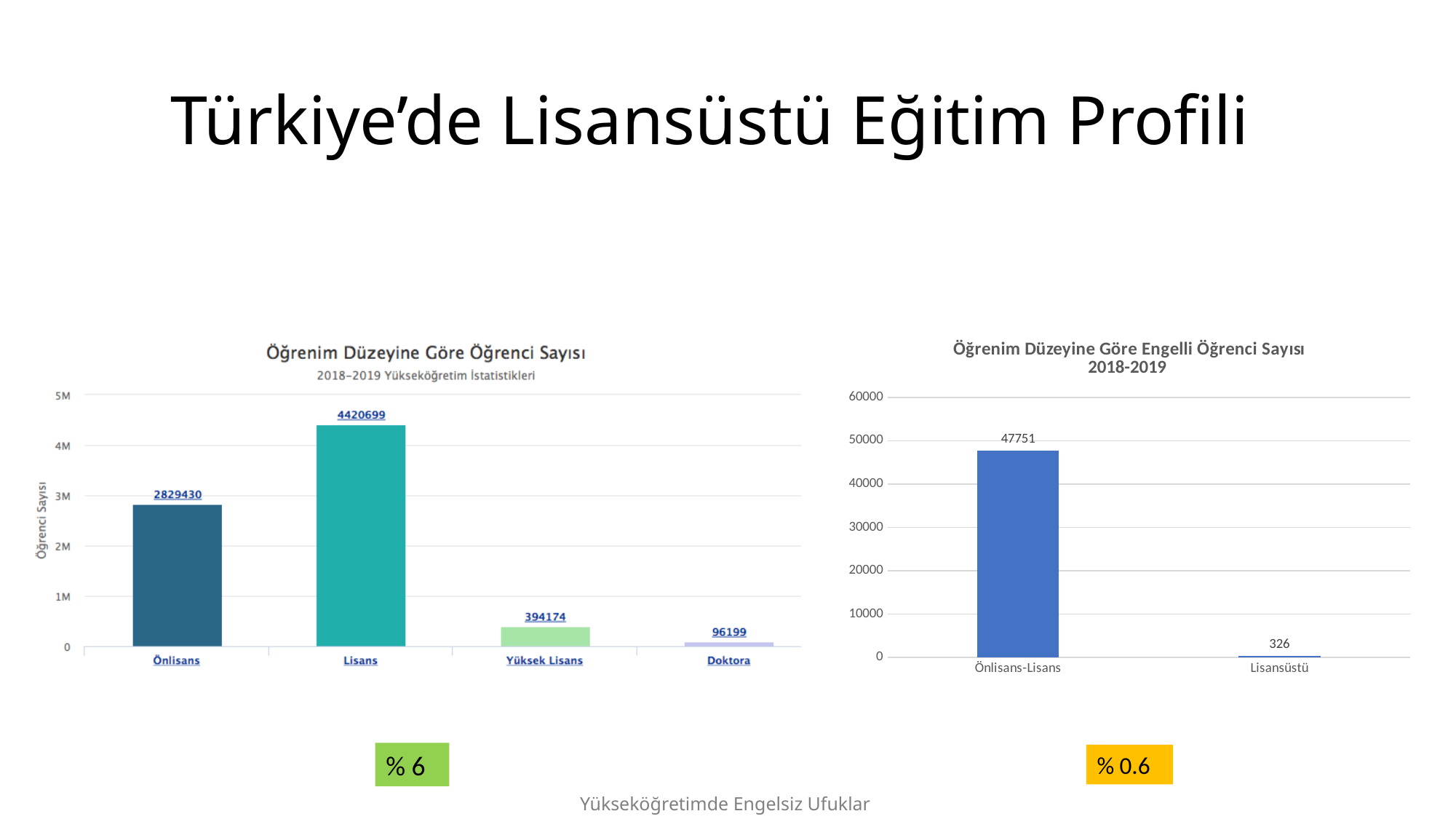
In the chart titled 'Öğrenim Düzeyine Göre Öğrenci Sayısı', which category has the lowest value? Doktora In the chart titled 'Öğrenim Düzeyine Göre Öğrenci Sayısı', which category has the highest value? Lisans In the chart titled 'Öğrenim Düzeyine Göre Engelli Öğrenci Sayısı 2018-2019', what is the value for Önlisans-Lisans? 47751 In the chart titled 'Öğrenim Düzeyine Göre Öğrenci Sayısı', how many categories are shown on the x axis? 4 In the chart titled 'Öğrenim Düzeyine Göre Öğrenci Sayısı', what is the value for Lisans? 4420699 What is the subtitle shown under the title of the chart on the left side of the slide? 2018-2019 Yükseköğretim İstatistikleri What kind of chart is the one on the right side of the slide? bar chart In the chart titled 'Öğrenim Düzeyine Göre Engelli Öğrenci Sayısı 2018-2019', what is the value for Lisansüstü? 326 In the chart titled 'Öğrenim Düzeyine Göre Öğrenci Sayısı', what is the value for Doktora? 96199 In the chart titled 'Öğrenim Düzeyine Göre Öğrenci Sayısı', what is the difference between the values for Lisans and Önlisans? 1591269 In the chart titled 'Öğrenim Düzeyine Göre Engelli Öğrenci Sayısı 2018-2019', what is the difference between the values for Önlisans-Lisans and Lisansüstü? 47425 In the chart titled 'Öğrenim Düzeyine Göre Öğrenci Sayısı', is the value for Önlisans greater or less than 3M? less